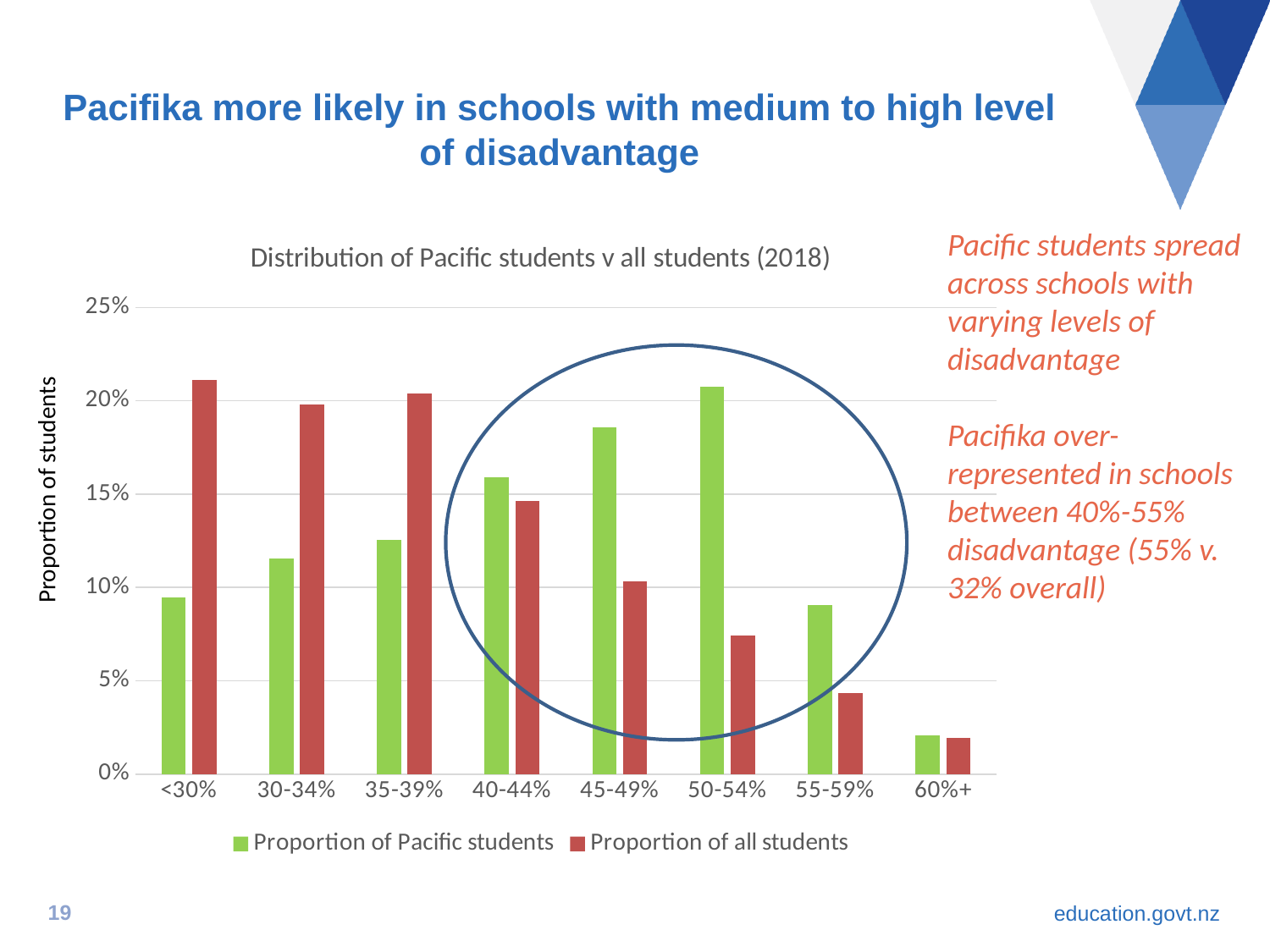
What kind of chart is shown on the slide? Bar chart How many disadvantage categories are shown on the x axis? 8 Which category has the highest proportion of all students? <30% Does the proportion of Pacific students rise or fall from the <30% category to the 50-54% category? Rise Is the proportion of all students in the 55-59% category greater or less than 5%? less In the 50-54% category, which is larger: the proportion of Pacific students or the proportion of all students? Proportion of Pacific students Which category has the lowest proportion of Pacific students? 60%+ What is the title of the chart? Distribution of Pacific students v all students (2018) How many series does the legend list? 2 In the <30% category, which is larger: the proportion of Pacific students or the proportion of all students? Proportion of all students Which category has the highest proportion of Pacific students? 50-54% Is the proportion of Pacific students in the 50-54% category greater or less than 20%? greater